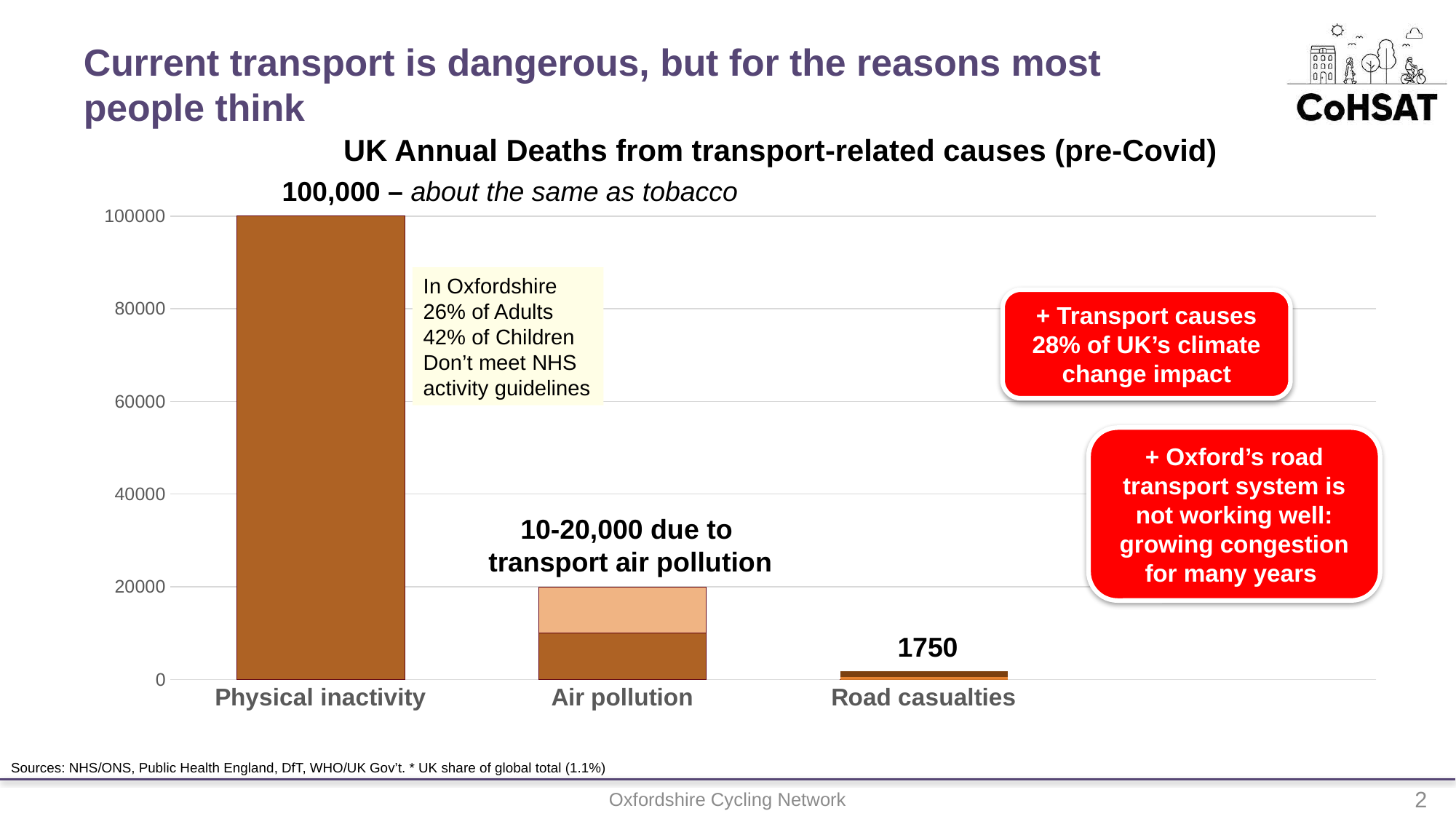
How many categories are shown on the x axis of the chart? 3 What value is labelled for Physical inactivity? 100,000 What range of deaths is labelled for Air pollution? 10-20,000 Which category has the lowest value in the chart? Road casualties What is the difference between the labelled values for Physical inactivity and Road casualties? 98,250 What is the title of the chart? UK Annual Deaths from transport-related causes (pre-Covid) What value is labelled for Road casualties? 1750 What kind of chart is shown on the slide? bar chart Which is larger, the value for Air pollution or the value for Road casualties? Air pollution Which category has the highest value in the chart? Physical inactivity Do the values rise or fall from left to right along the x axis? fall Is the value for Air pollution greater or less than 40000? less